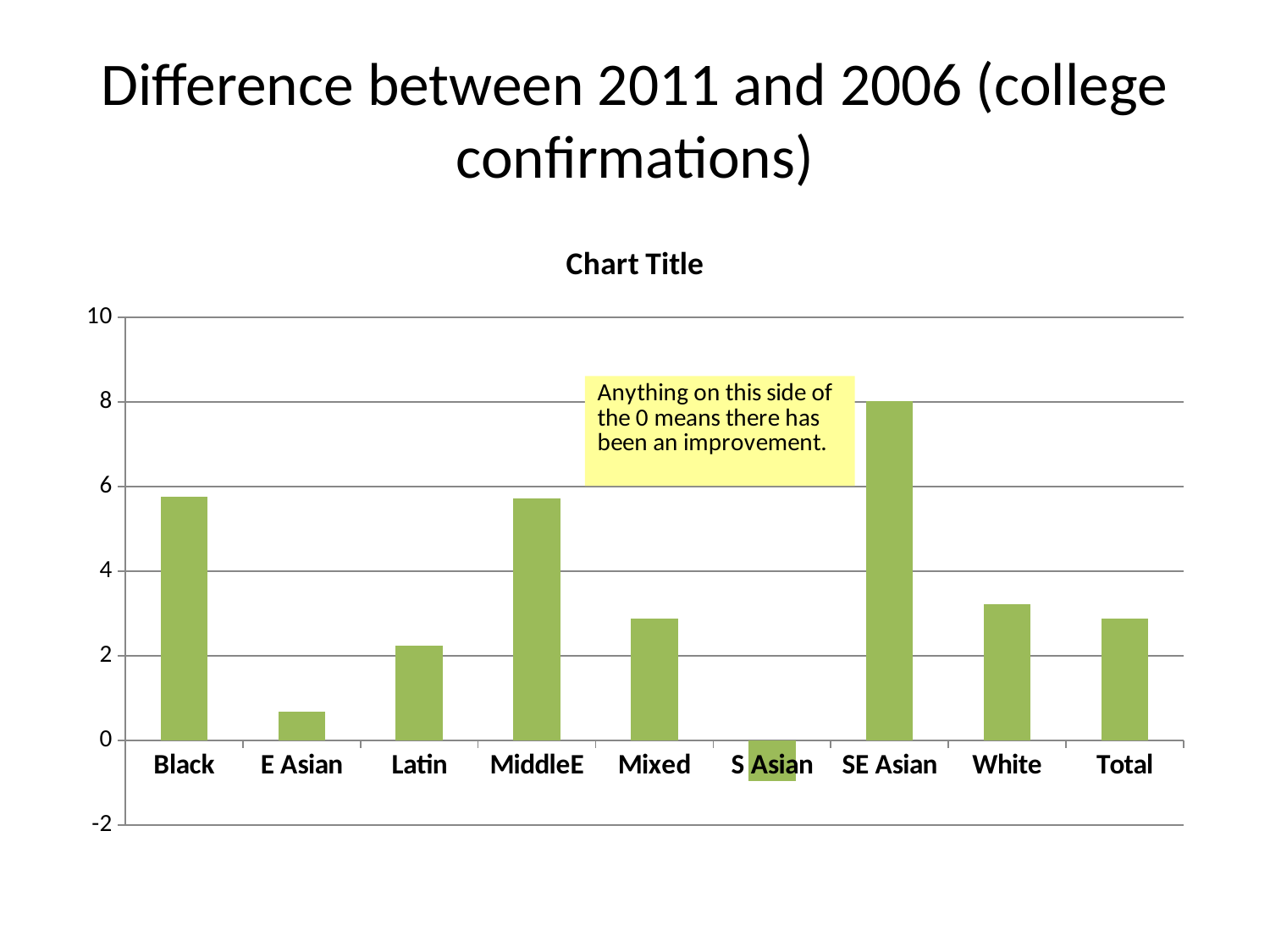
Which is larger, the value for SE Asian or the value for White? SE Asian Is the value for S Asian greater or less than 0? less What kind of chart is shown on the slide? bar chart Which is larger, the value for Black or the value for E Asian? Black Which category has the highest value in the chart? SE Asian Is the value for White greater or less than 4? less Is the value for E Asian greater or less than 2? less What is the title printed above the chart's plot area? Chart Title Which category has the lowest value in the chart? S Asian How many categories are shown on the x axis of the chart? 9